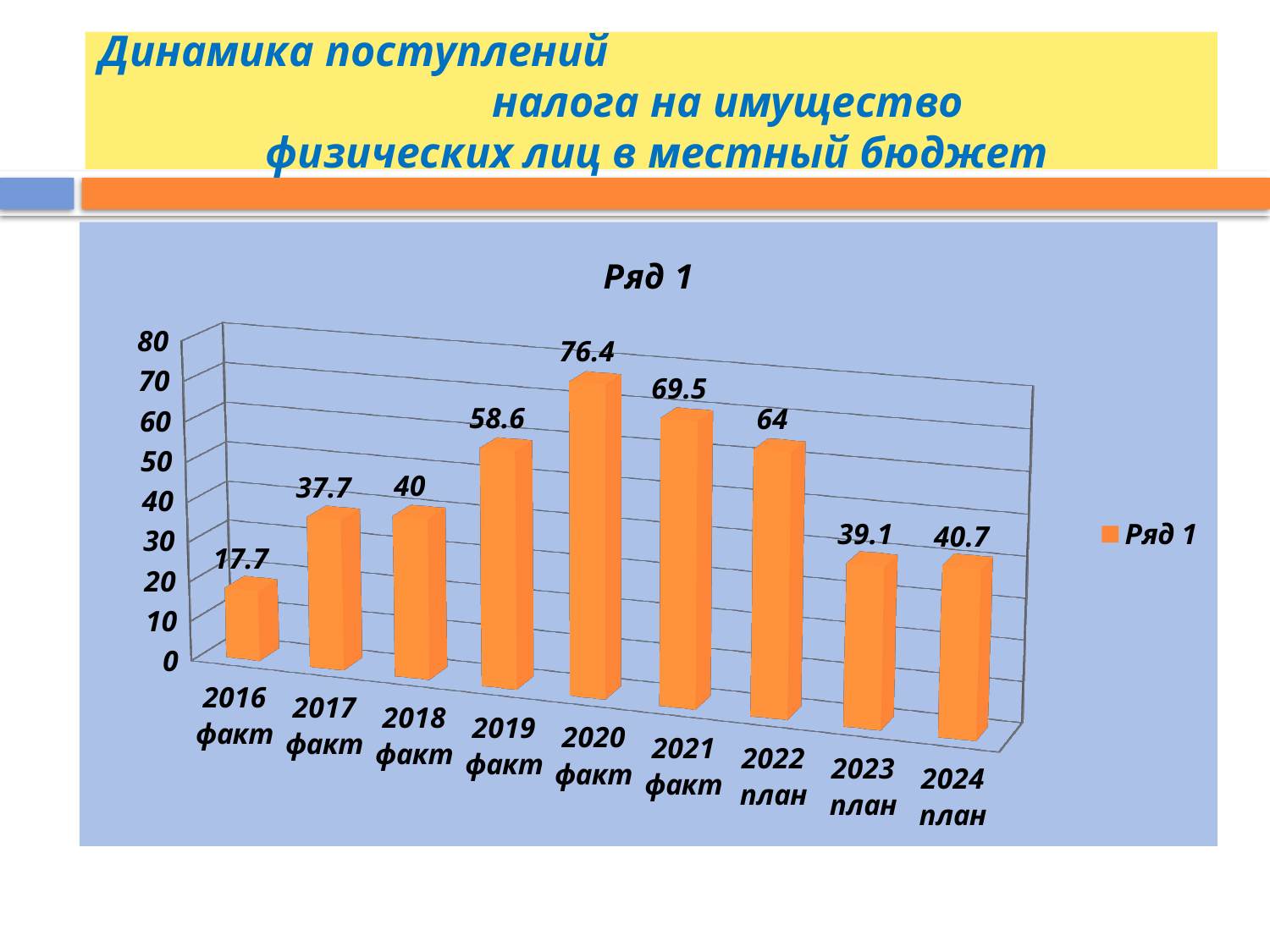
How many categories are shown on the x axis? 9 Which category has the lowest value? 2016 факт What is the value for 2016 факт? 17.7 Is the value for 2018 факт greater or less than 50? less How many series does the legend list? 1 What is the title of the chart? Ряд 1 What is the value for 2020 факт? 76.4 What is the difference between the values for 2020 факт and 2021 факт? 6.9 Which is larger, the value for 2019 факт or the value for 2022 план? 2022 план Which category has the highest value? 2020 факт What kind of chart is shown on the slide? bar chart What is the value for 2023 план? 39.1